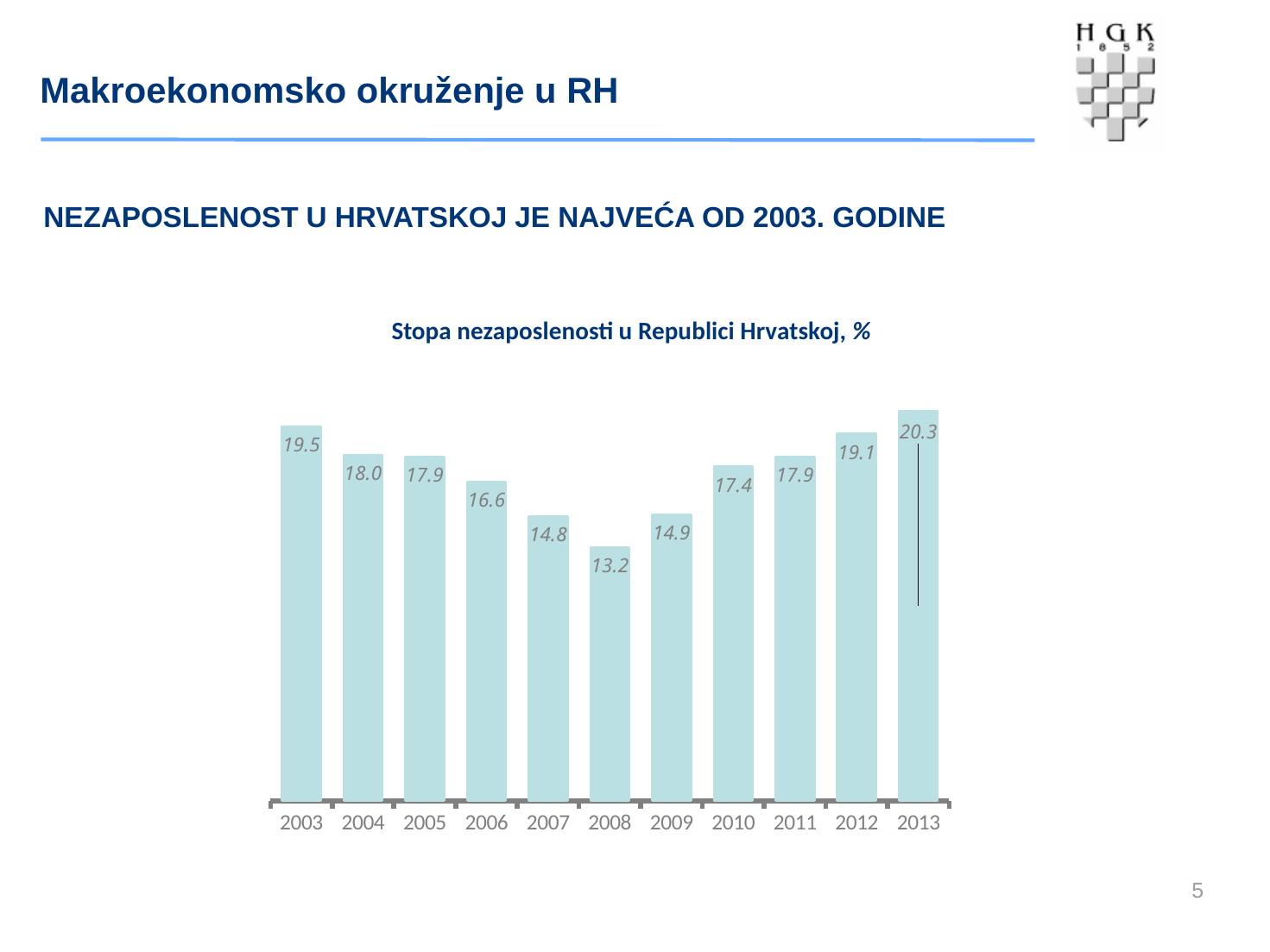
What is the value shown for 2006? 16.6 What is the difference between the values for 2013 and 2008? 7.1 Which year has the highest unemployment rate? 2013 What is the unemployment rate shown for 2008? 13.2 How many years are shown on the x axis? 11 Which is larger, the value for 2012 or the value for 2010? 2012 What is the difference between the values for 2003 and 2004? 1.5 What is the unemployment rate shown for 2013? 20.3 What is the title of the chart? Stopa nezaposlenosti u Republici Hrvatskoj, % Do the values rise or fall from 2008 to 2013? rise What kind of chart is this? bar chart Which year has the lowest unemployment rate? 2008